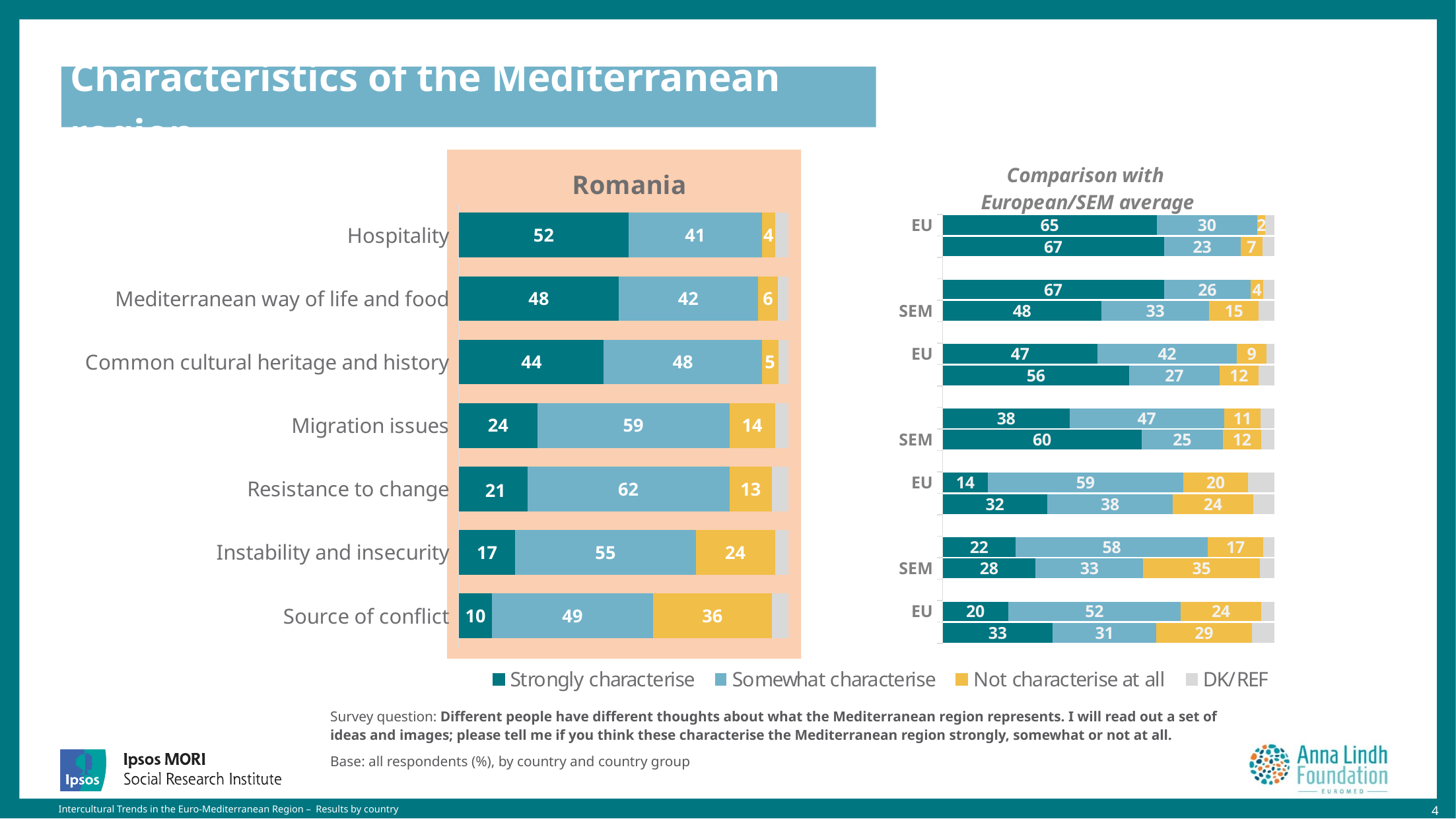
In the Romania chart, which category has the lowest 'Strongly characterise' value? Source of conflict What type of chart is the Romania chart? Stacked bar chart In the Romania chart, which category has the highest 'Strongly characterise' value? Hospitality How many categories are shown in the Romania chart? 7 In the Romania chart, what percentage say Hospitality strongly characterises the Mediterranean region? 52 In the Romania chart, what is the 'Not characterise at all' value for Source of conflict? 36 In the 'Comparison with European/SEM average' chart, what is the 'Not characterise at all' value for SEM in the bottom (Source of conflict) row? 29 In the Romania chart, what is the 'Somewhat characterise' value for Resistance to change? 62 In the Romania chart, what is the difference between the 'Strongly characterise' values for Hospitality and Migration issues? 28 In the Romania chart, which is larger: the 'Not characterise at all' value for Instability and insecurity or for Migration issues? Instability and insecurity How many series does the legend list? 4 In the 'Comparison with European/SEM average' chart, what is the 'Strongly characterise' value for the EU in the top (Hospitality) row? 65